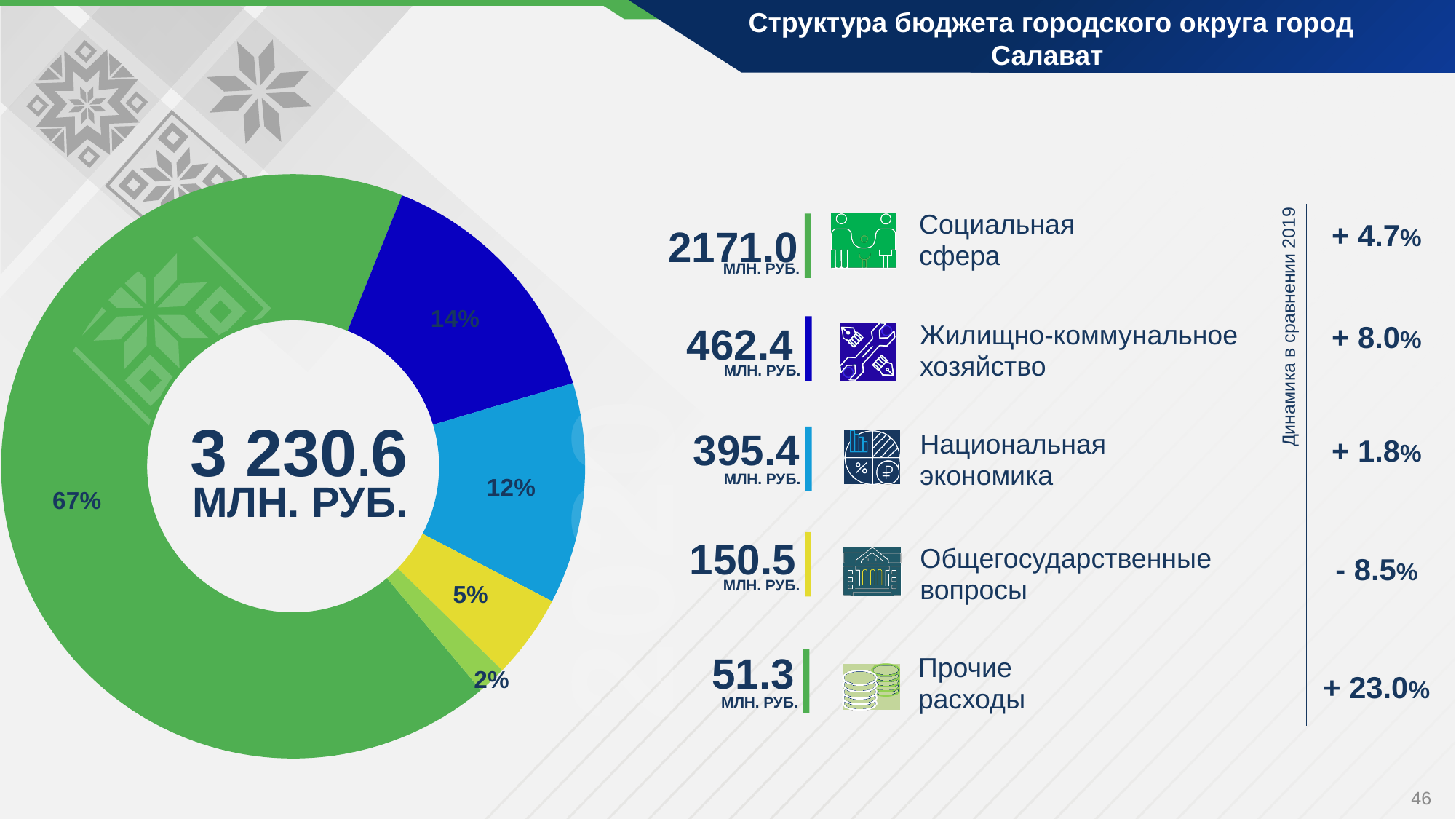
What total value is printed in the centre of the donut chart? 3 230.6 млн. руб. What share of the budget does Прочие расходы represent? 2% What share of the budget does Жилищно-коммунальное хозяйство represent? 14% How many categories are shown in the donut chart? 5 What share of the budget does the largest slice (Социальная сфера) represent? 67% What is the value in млн. руб. for Общегосударственные вопросы? 150.5 What is the value in млн. руб. for Жилищно-коммунальное хозяйство? 462.4 What kind of chart is shown on the slide? Pie (donut) chart Which category has the smallest slice of the donut chart? Прочие расходы Which category has the largest slice of the donut chart? Социальная сфера What is the difference in percentage points between the Социальная сфера slice (67%) and the Жилищно-коммунальное хозяйство slice (14%)? 53 percentage points